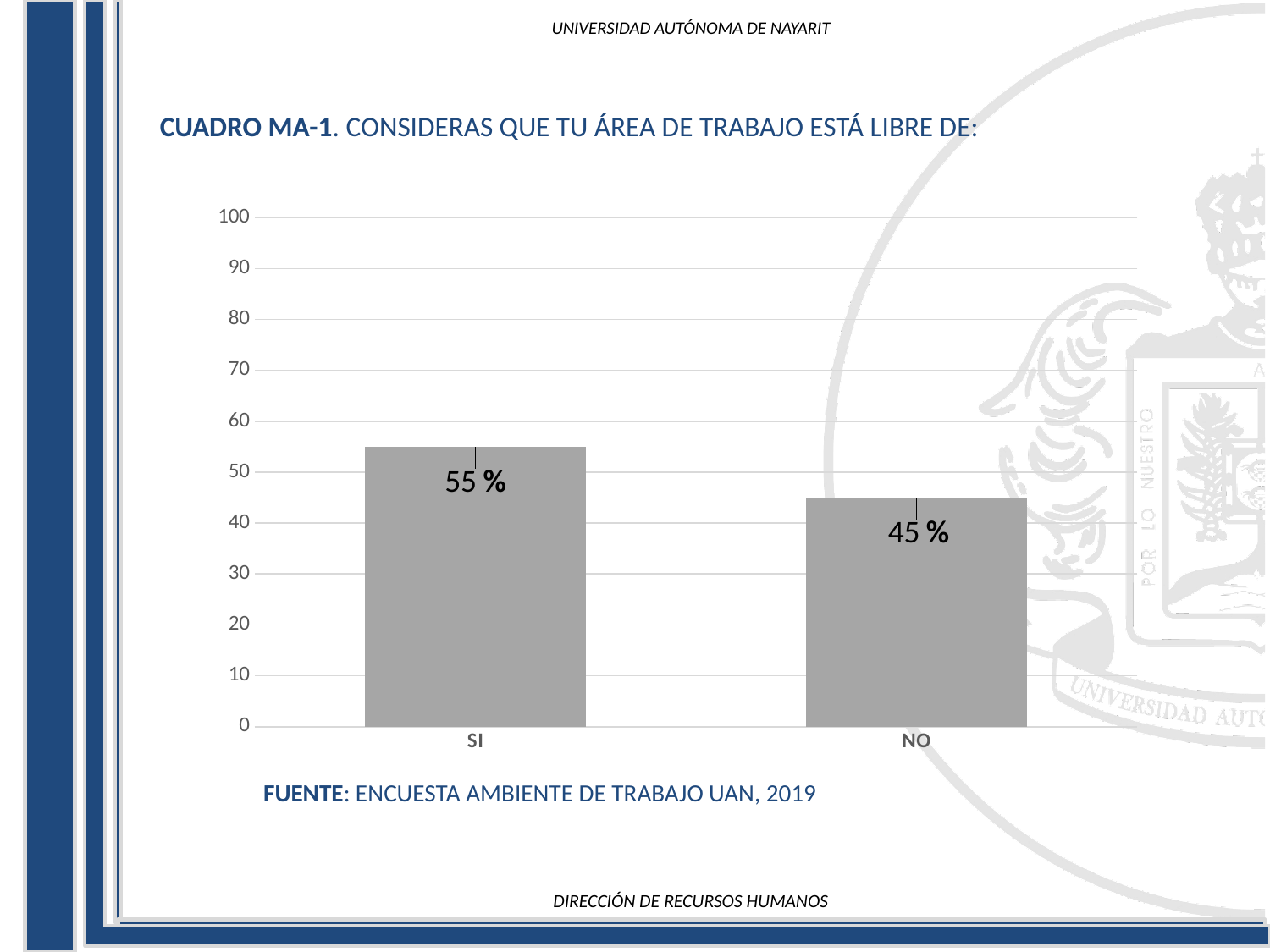
What is the difference between the values for SI and NO? 10 % Which category has the lowest value? NO What is the value for SI? 55 % How many categories are shown on the x axis? 2 Is the value for SI greater or less than 50? greater What is the title of the chart? CUADRO MA-1. CONSIDERAS QUE TU ÁREA DE TRABAJO ESTÁ LIBRE DE: Which category has the highest value? SI What kind of chart is shown on the slide? bar chart What source is cited below the chart? ENCUESTA AMBIENTE DE TRABAJO UAN, 2019 What is the value for NO? 45 % Is the value for NO greater or less than 50? less Which is larger, the value for SI or the value for NO? SI